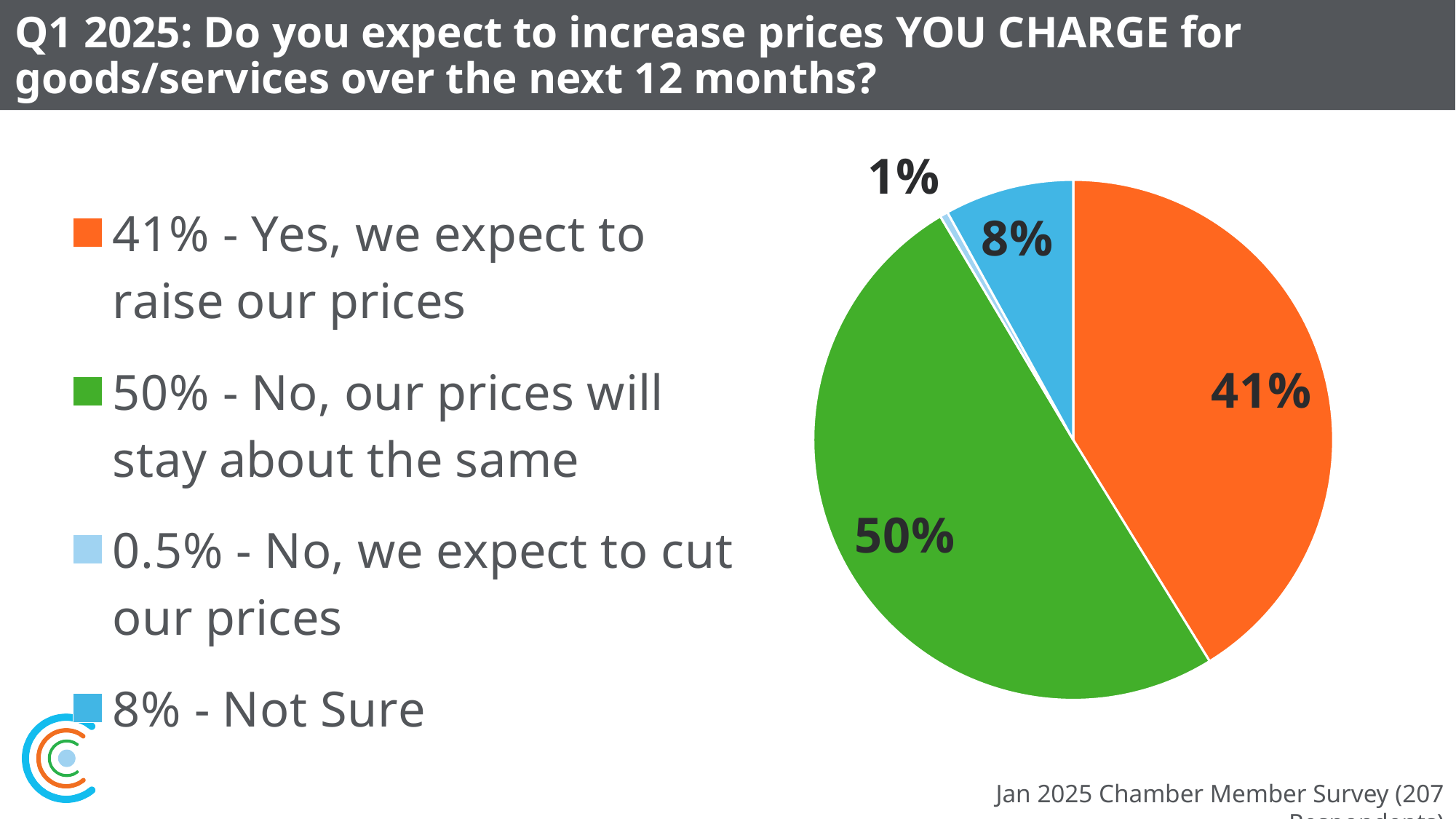
How many response categories does the pie chart show? 4 What colour is the slice for "Yes, we expect to raise our prices"? Orange How many percentage points larger is the "raise our prices" share than the "Not Sure" share? 33 percentage points Which response has the largest slice of the pie? No, our prices will stay about the same Which is larger: the share expecting to raise prices or the share that is Not Sure? Yes, we expect to raise our prices What kind of chart is shown on the slide? Pie chart What share of respondents said "Yes, we expect to raise our prices"? 41% How many percentage points larger is the "stay about the same" share than the "raise our prices" share? 9 percentage points What share of respondents answered "Not Sure"? 8% Which response has the smallest slice of the pie? No, we expect to cut our prices What share of respondents said "No, our prices will stay about the same"? 50% What survey is cited as the source at the bottom right of the slide? Jan 2025 Chamber Member Survey